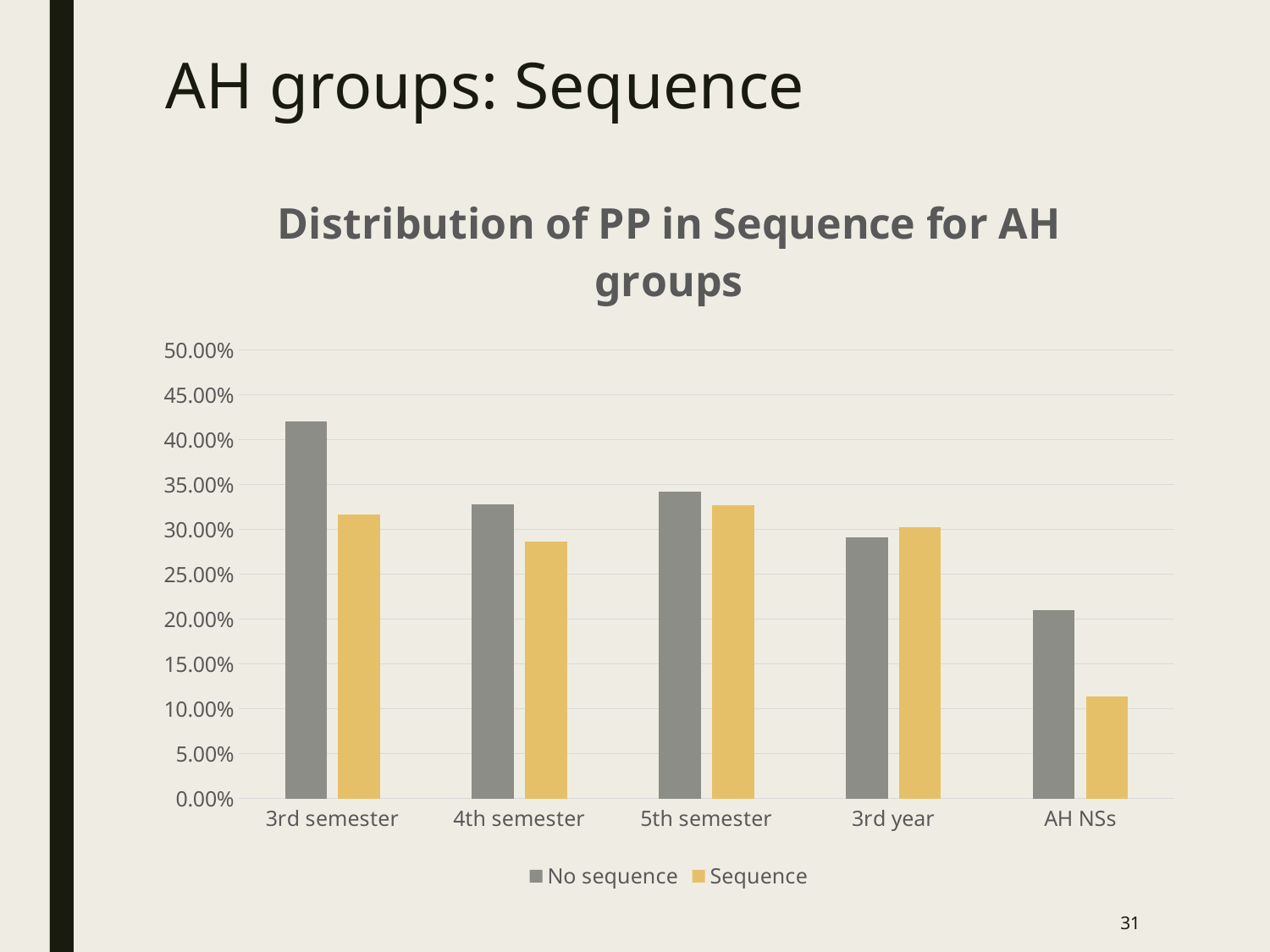
For 3rd semester, which is larger: No sequence or Sequence? No sequence Is the Sequence value for AH NSs greater or less than 15.00%? less How many categories are shown on the x axis? 5 Is the No sequence value for 3rd semester greater or less than 40.00%? greater How many series does the legend list? 2 Which category has the lowest value for the Sequence series? AH NSs What is the title of the chart? Distribution of PP in Sequence for AH groups Which colour represents the Sequence series in the legend? yellow Which category has the lowest value for the No sequence series? AH NSs Which category has the highest value for the No sequence series? 3rd semester What kind of chart is shown on the slide? bar chart For AH NSs, which is larger: No sequence or Sequence? No sequence